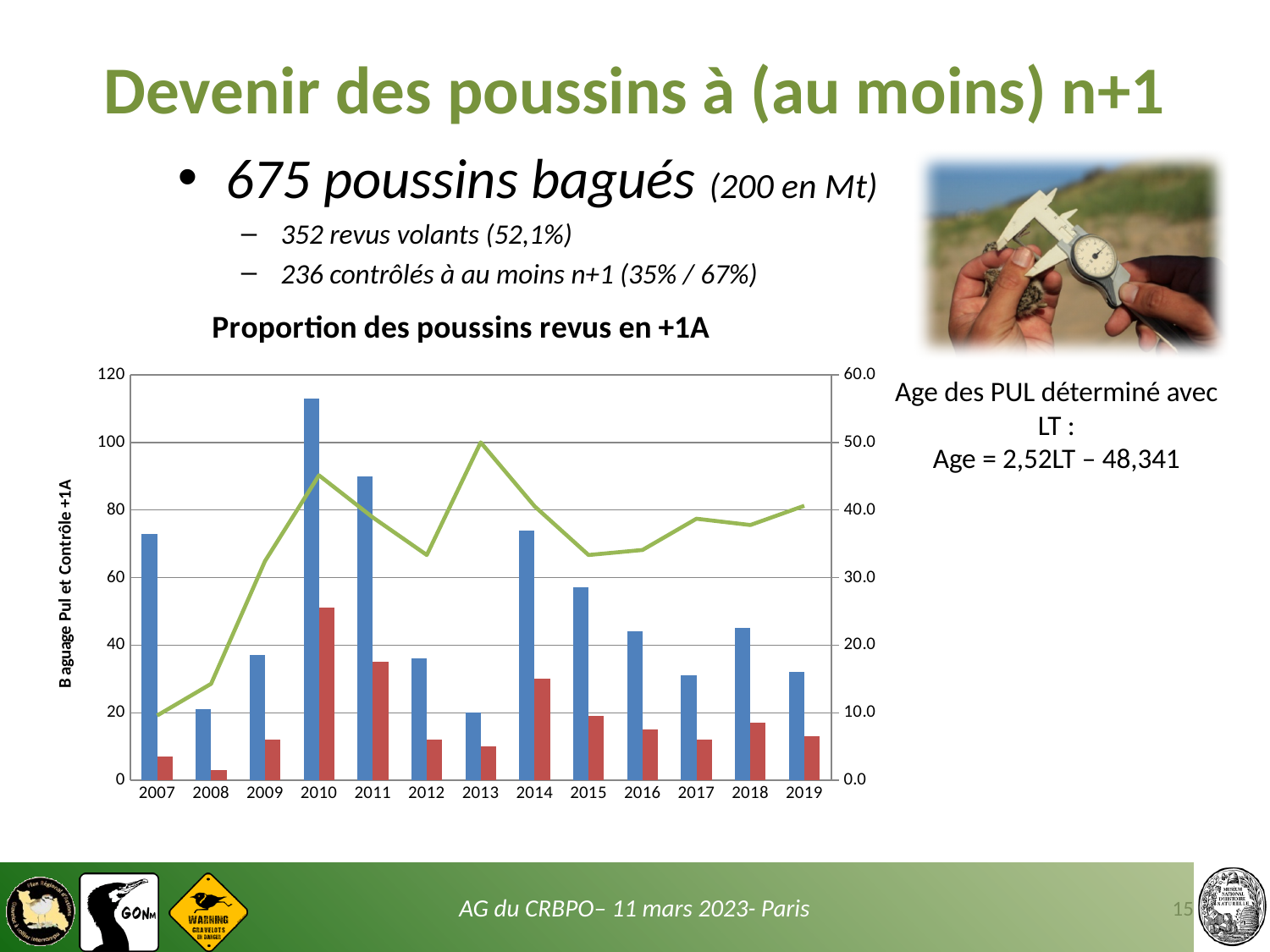
How many years are shown on the x axis of the chart? 13 What kind of chart is shown under the title 'Proportion des poussins revus en +1A'? bar chart with a line Is the red bar for 2010 greater or less than 40 on the left axis? greater In which year does the green line reach its highest point? 2013 Which year has the taller blue bar, 2014 or 2015? 2014 What is the label on the left vertical axis of the chart? Baguage Pul et Contrôle +1A Is the blue bar for 2013 greater or less than 40 on the left axis? less Does the green line rise or fall from 2007 to 2010? rise Is the blue bar for 2010 greater or less than 100 on the left axis? greater In which year is the blue bar the tallest? 2010 In which year is the red bar the shortest? 2008 In which year is the red bar the tallest? 2010